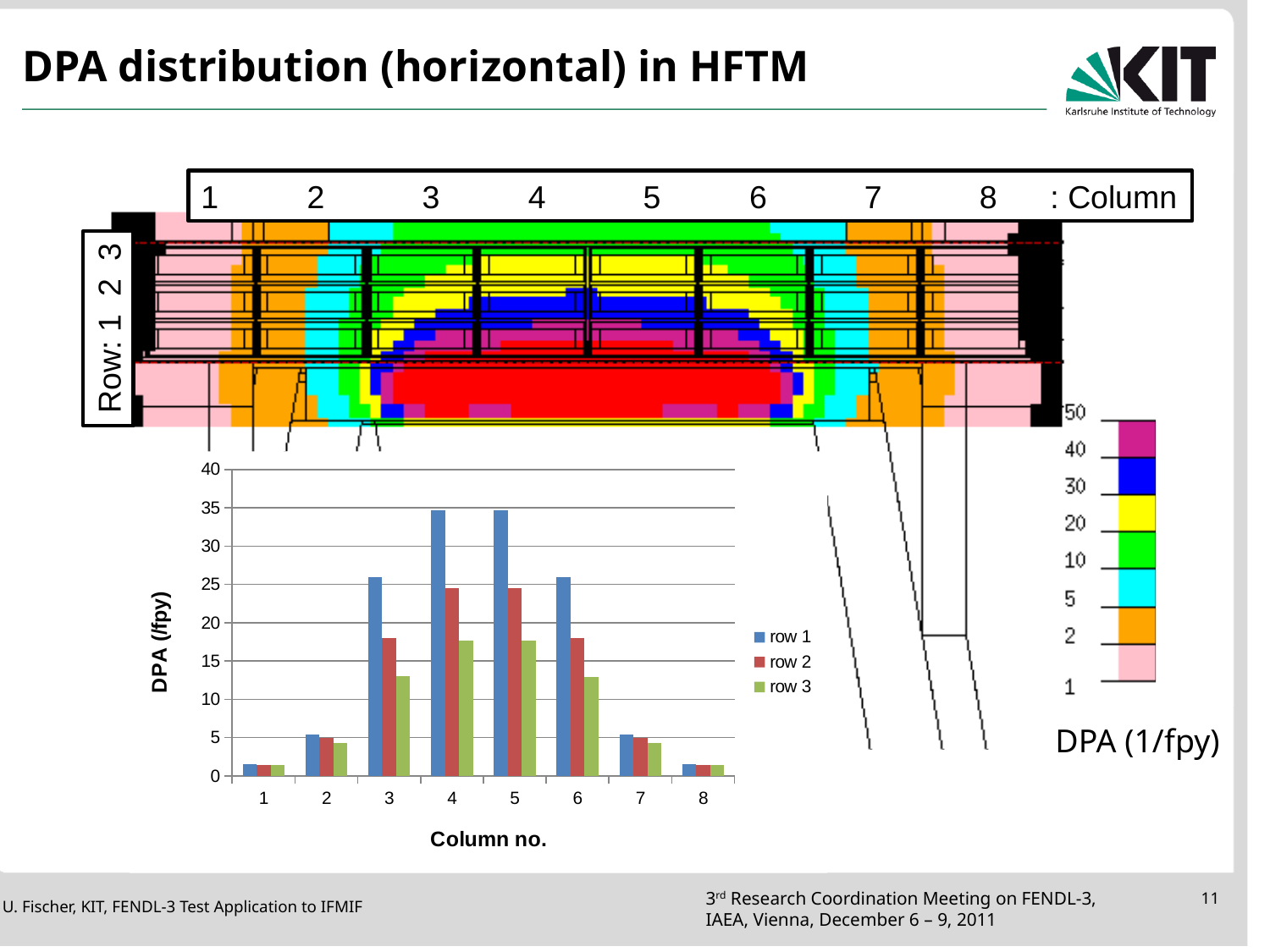
Is the row 3 value at column 3 greater or less than 15? less What kind of chart is shown on the slide? bar chart What is the title of the y axis of the bar chart? DPA (/fpy) How many series does the legend of the bar chart list? 3 Is the row 1 value at column 4 greater or less than 30? greater Do the row 1 values rise or fall from column 5 to column 8? fall Is the row 1 value at column 2 greater or less than 10? less At column 3, which series has the larger value, row 2 or row 3? row 2 At column 4, which series has the larger value, row 1 or row 3? row 1 How many column categories are plotted along the x axis of the bar chart? 8 Which series has the highest value at column 5? row 1